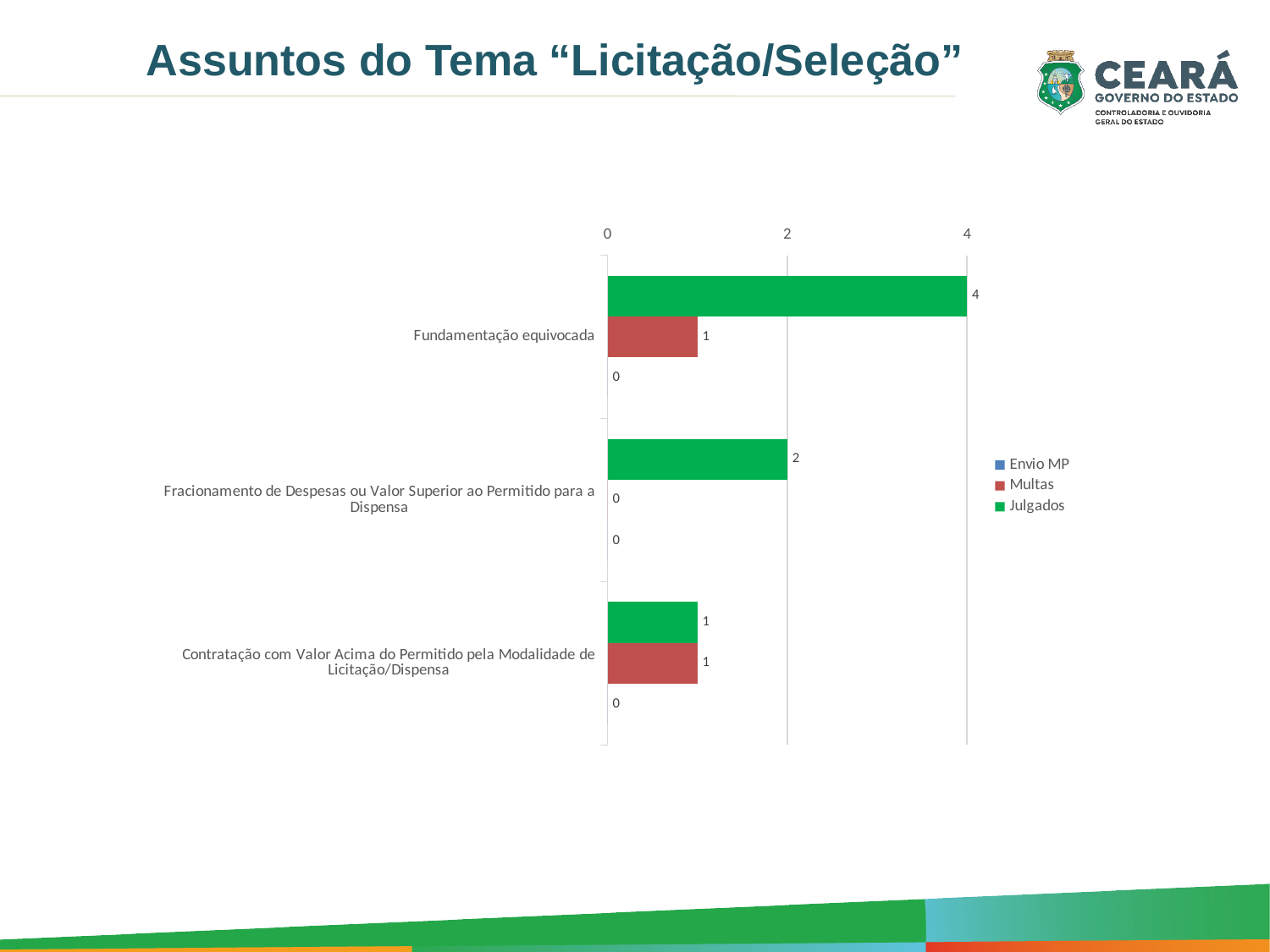
What is the Multas value for Fundamentação equivocada? 1 How many categories are shown on the chart? 3 What is the Envio MP value for Contratação com Valor Acima do Permitido pela Modalidade de Licitação/Dispensa? 0 What is the difference between the Julgados values for Fundamentação equivocada and Fracionamento de Despesas ou Valor Superior ao Permitido para a Dispensa? 2 How many series does the legend list? 3 What is the Julgados value for Fracionamento de Despesas ou Valor Superior ao Permitido para a Dispensa? 2 What is the Julgados value for Fundamentação equivocada? 4 What kind of chart is shown on the slide? Bar chart Which category has the highest Julgados value? Fundamentação equivocada Which category has the lowest Julgados value? Contratação com Valor Acima do Permitido pela Modalidade de Licitação/Dispensa Which is larger: the Julgados value or the Multas value for Fundamentação equivocada? Julgados Which series is shown in green in the legend? Julgados